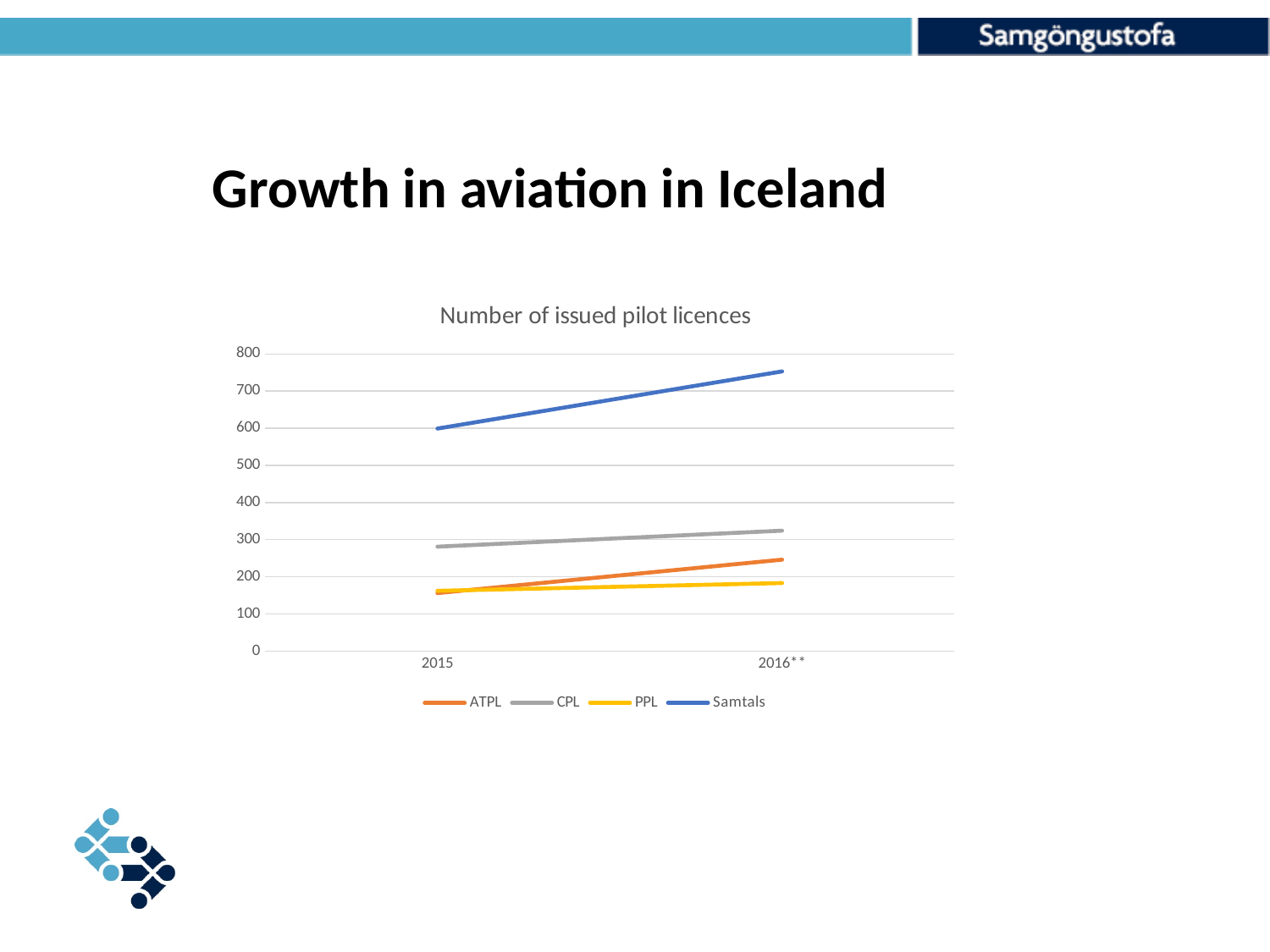
Does the Samtals line rise or fall from 2015 to 2016**? rise What is the title of the chart? Number of issued pilot licences Is the value for Samtals in 2015 greater or less than 500? greater Is the value for ATPL in 2016** greater or less than 200? greater Which is larger in 2015, the value for CPL or the value for ATPL? CPL Does the ATPL line rise or fall from 2015 to 2016**? rise Which series has the lowest value in 2016**? PPL Which series has the highest values in the chart? Samtals What kind of chart is shown on the slide? line chart Is the value for Samtals in 2016** greater or less than 700? greater How many series does the legend list? 4 How many points are plotted along the x axis for each series? 2